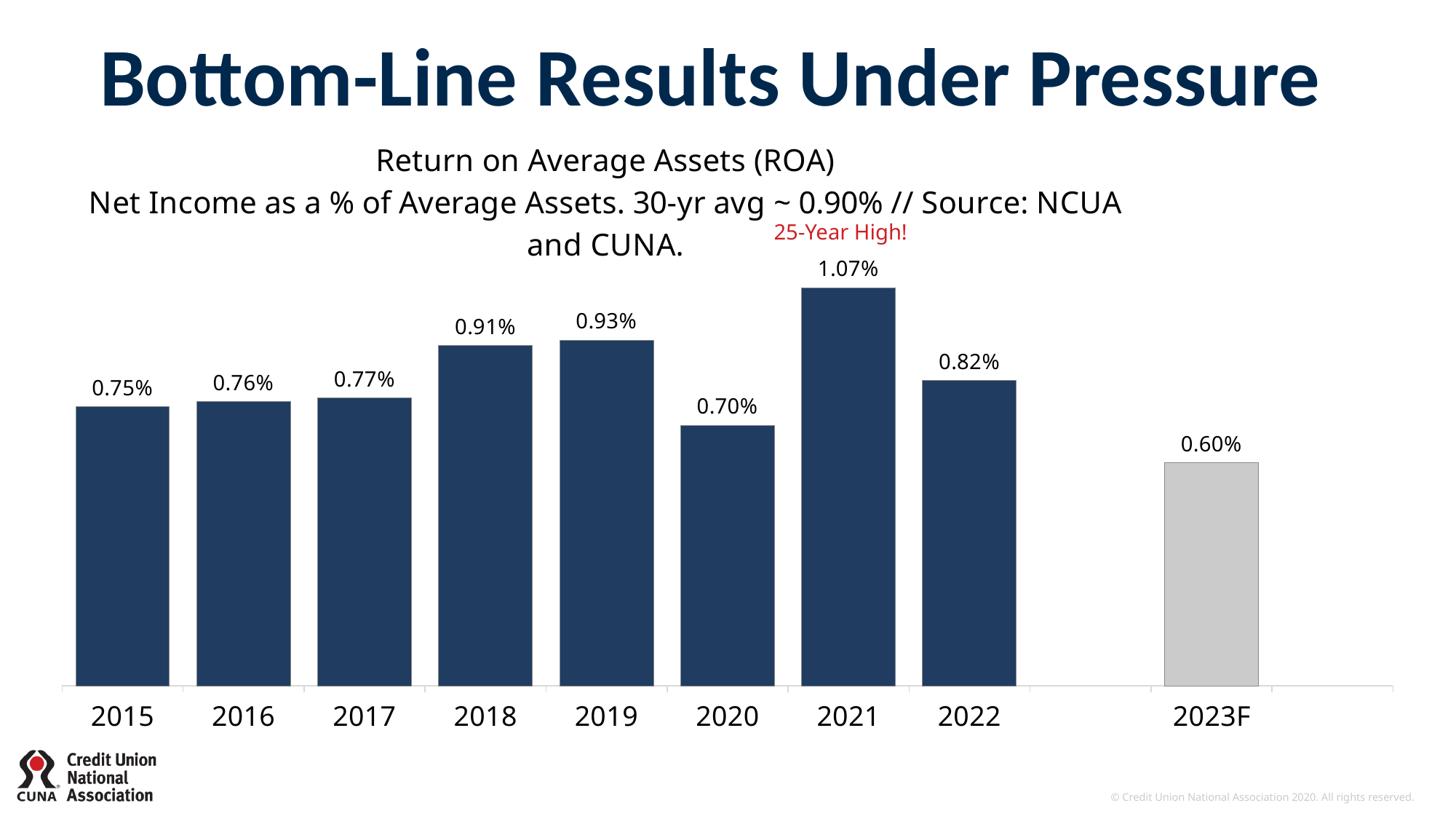
How many years are shown on the x axis? 9 What is the ROA value for 2018? 0.91% Does the ROA rise or fall from 2015 to 2019? Rise Which bar is labelled '25-Year High!'? 2021 What is the forecast ROA value for 2023F? 0.60% What kind of chart is shown on the slide? Bar chart Which year has a higher ROA, 2019 or 2022? 2019 What is the difference between the ROA in 2021 and the ROA in 2022? 0.25% What is the ROA value for 2021? 1.07% Which year has the highest ROA? 2021 Which year has the lowest ROA? 2023F What is the difference between the ROA in 2019 and the ROA in 2020? 0.23%